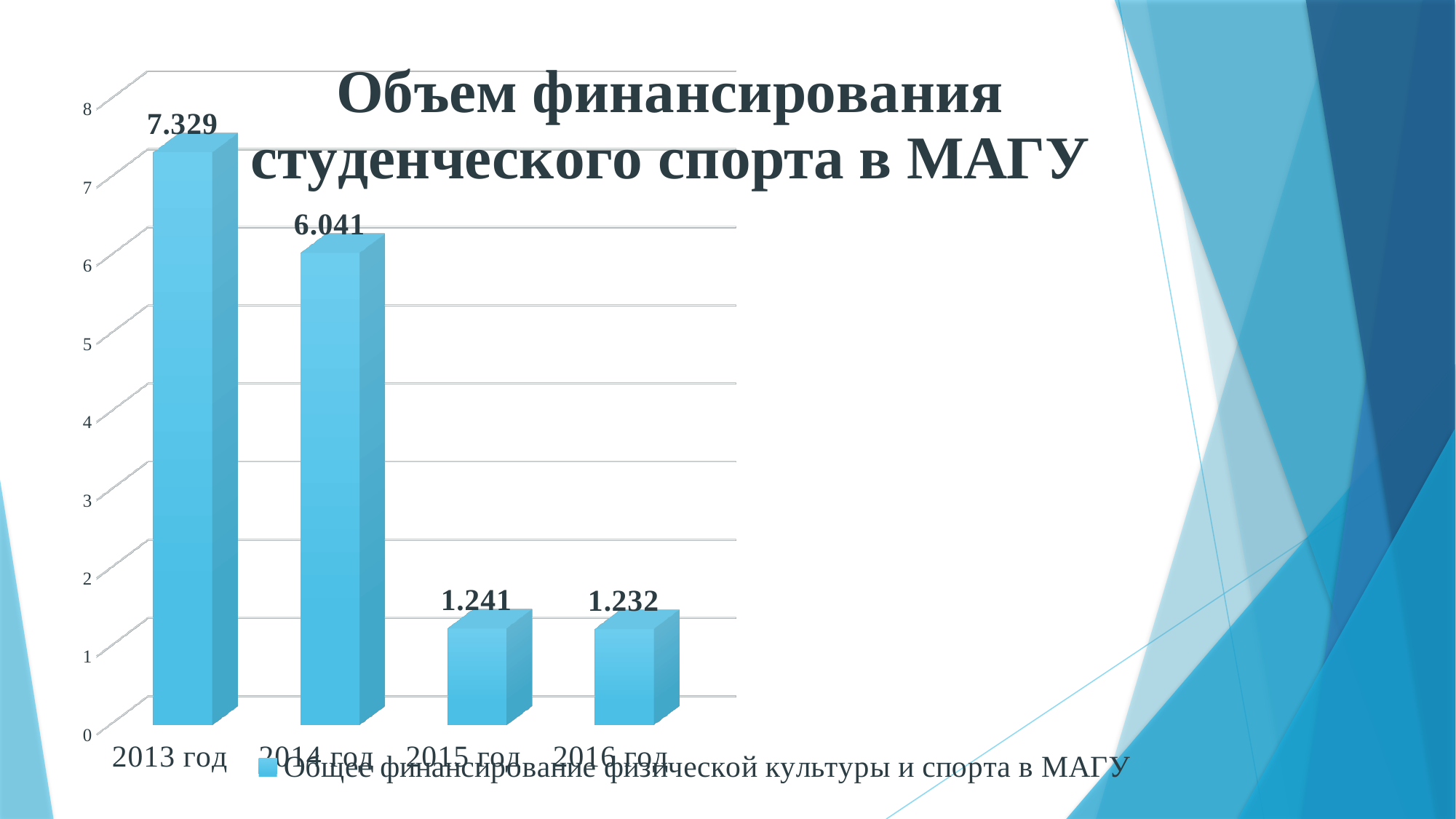
What is the value for 2013 год? 7.329 Which year has the highest value? 2013 год What is the difference between the values for 2013 год and 2014 год? 1.288 What is the value for 2016 год? 1.232 Which year has the lowest value? 2016 год Which is larger, the value for 2015 год or the value for 2016 год? 2015 год What is the difference between the values for 2014 год and 2015 год? 4.800 How many years are shown on the x axis? 4 Do the values rise or fall from 2013 год to 2016 год? Fall What kind of chart is shown on the slide? Bar chart What is the value for 2015 год? 1.241 Is the value for 2014 год greater or less than 5? greater